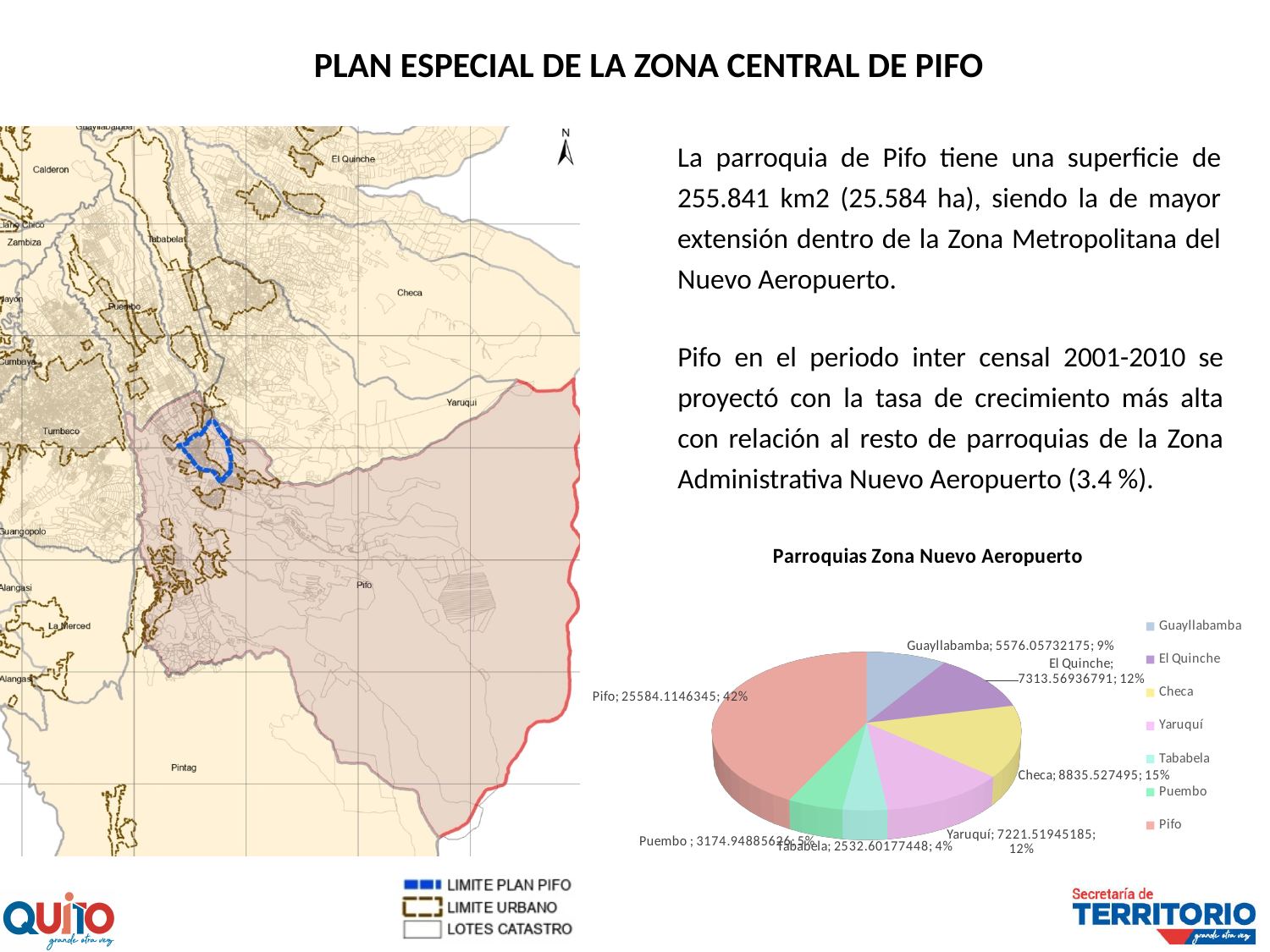
How many parroquias (slices) does the pie chart 'Parroquias Zona Nuevo Aeropuerto' show? 7 By how many percentage points does Pifo's share exceed Checa's share? 27 How many entries does the legend of the pie chart list? 7 What kind of chart is shown under the title 'Parroquias Zona Nuevo Aeropuerto'? pie chart Which parroquia has the largest slice in the pie chart? Pifo What is the title of the pie chart? Parroquias Zona Nuevo Aeropuerto What value is labelled for Checa in the pie chart? 8835.527495 What share of the pie does Checa represent? 15% Which has the larger share in the pie chart, Checa or El Quinche? Checa What share of the pie does Pifo represent? 42% Which parroquia has the smallest slice in the pie chart? Tababela What value is labelled for Pifo in the pie chart? 25584.1146345